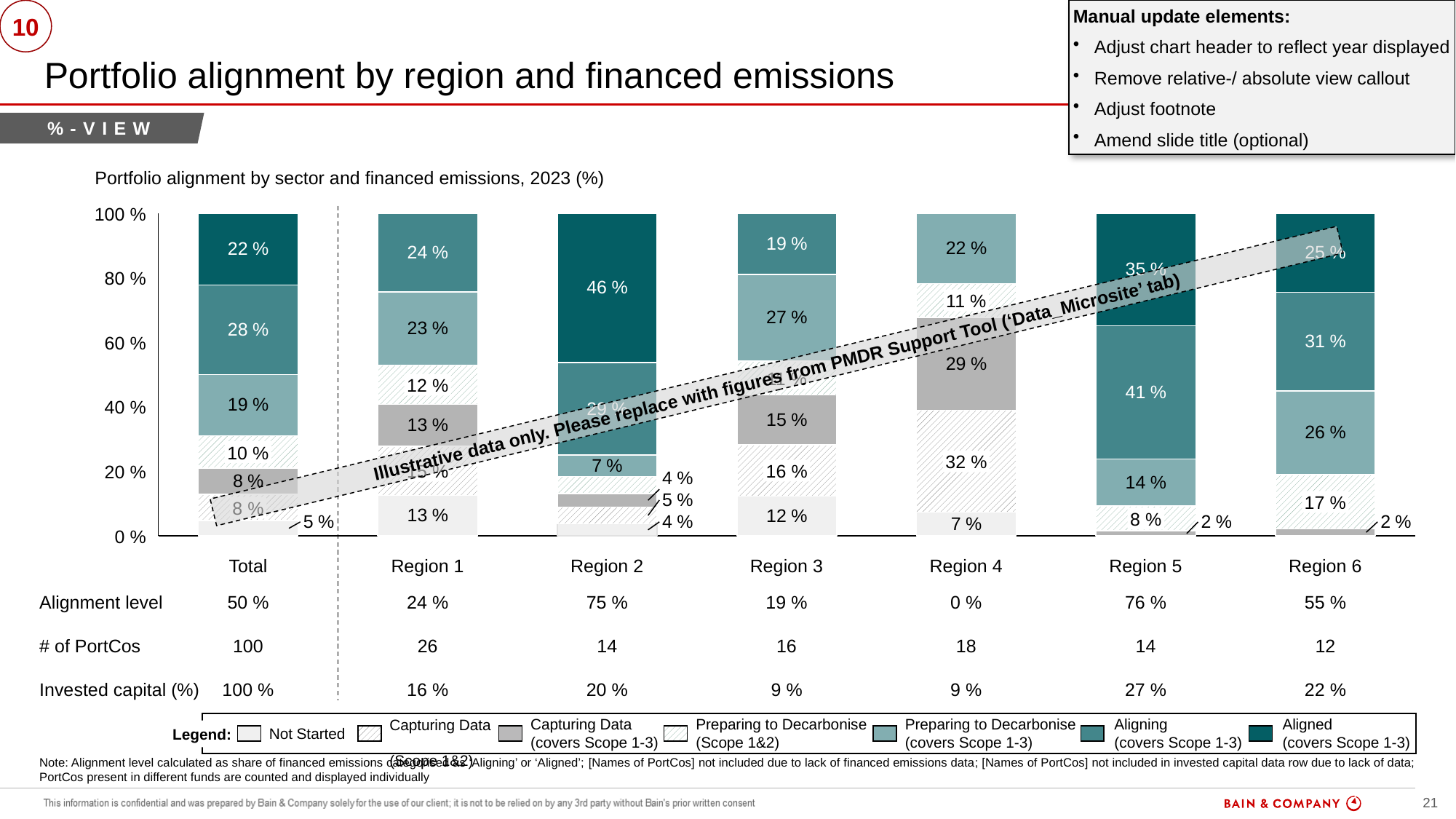
Which has a larger Aligned (covers Scope 1-3) share, Region 5 or Region 6? Region 5 What kind of chart is shown on the slide? Stacked bar chart What is the Aligning (covers Scope 1-3) share for Region 5? 41 % What is the Alignment level for Region 5? 76 % What is the # of PortCos for Region 4? 18 What is the Not Started share for Region 1? 13 % How many categories (bars) are shown along the x axis of the chart? 7 What is the Aligned (covers Scope 1-3) share for Region 2? 46 % Which region has the largest Aligned (covers Scope 1-3) segment? Region 2 How many series does the chart legend list? 7 What is the title of the chart? Portfolio alignment by sector and financed emissions, 2023 (%)